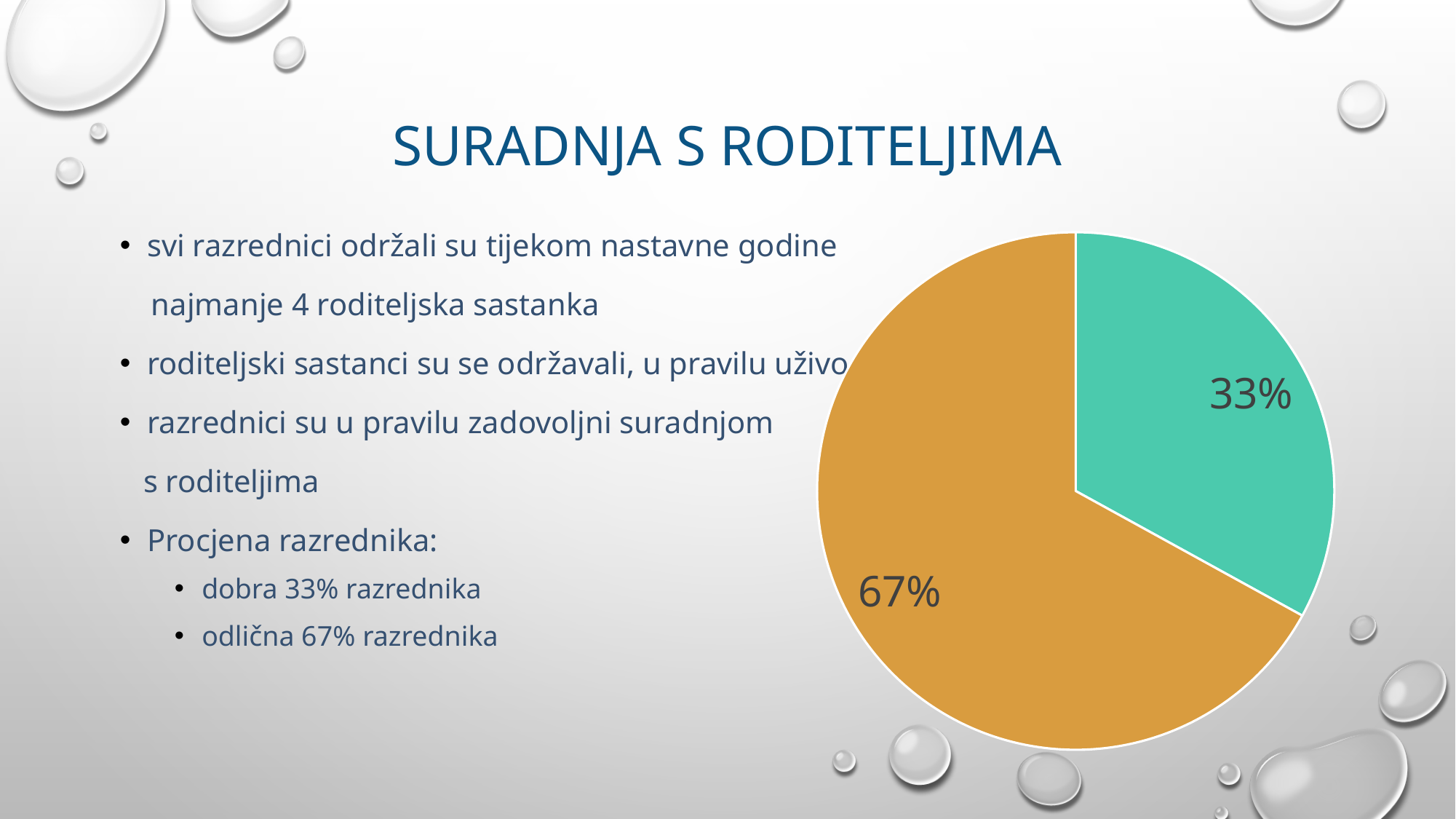
How many slices does the pie chart have? 2 What is the difference between the orange slice and the teal slice in the pie chart? 34 percentage points What share of the pie does the teal slice represent? 33% What do the two labelled slices of the pie chart add up to? 100% Does the pie chart display a legend? No Which is larger in the pie chart, the orange slice or the teal slice? the orange slice What kind of chart is shown on the slide? pie chart What value is labelled on the orange slice of the pie chart? 67% Which slice of the pie chart is the smallest? the teal slice (33%) Which slice of the pie chart is the largest? the orange slice (67%) Is the orange slice of the pie chart greater or less than 50%? greater What value is labelled on the teal (green) slice of the pie chart? 33%